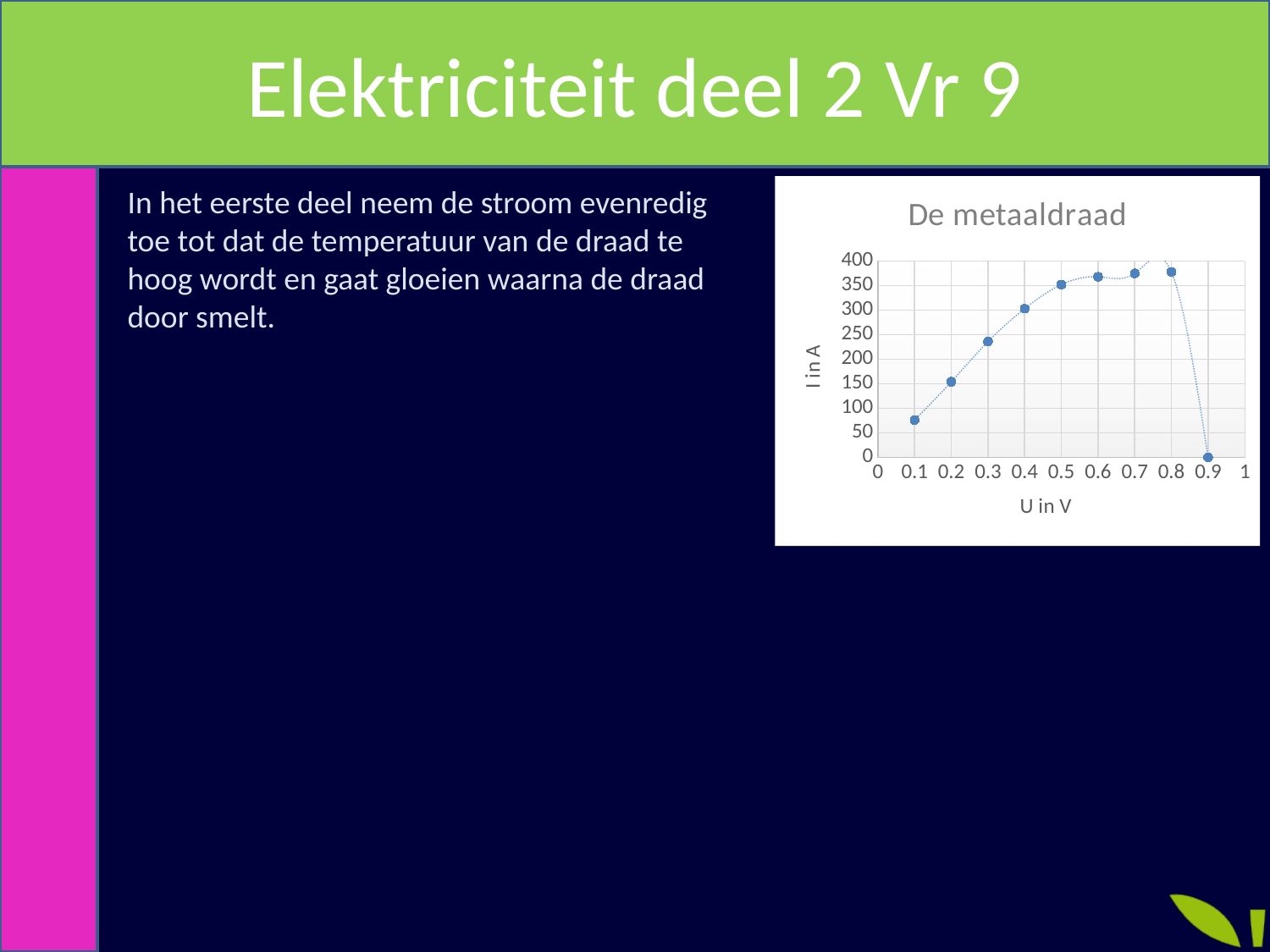
Does the current rise or fall as U increases from 0.1 V to 0.5 V? rise What is the label of the x axis of the chart? U in V What is the title of the chart? De metaaldraad What is the value of I at U = 0.9 V? 0 What kind of chart is shown on the slide? line chart Is the value for U = 0.3 V greater or less than 200? greater How many data points are plotted on the chart? 9 Is the value for U = 0.1 V greater or less than 100? less Is the value for U = 0.2 V greater or less than 100? greater Which has a larger current: U = 0.2 V or U = 0.3 V? U = 0.3 V At which value of U is the plotted current lowest? 0.9